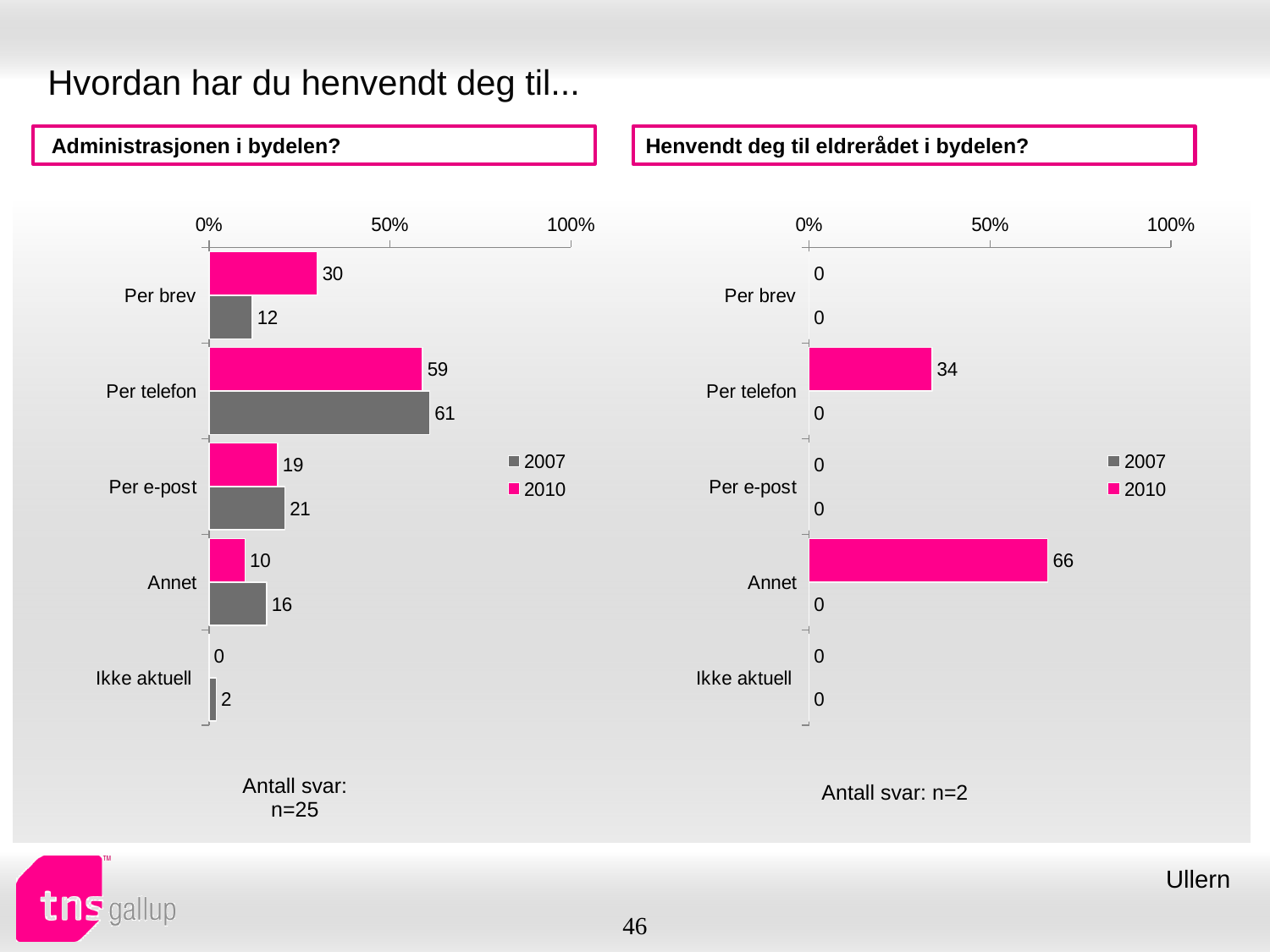
In the 'Administrasjonen i bydelen?' chart, is the 2007 value for Per telefon greater or less than 50%? greater In the 'Henvendt deg til eldrerådet i bydelen?' chart, what is the value for Annet in 2010? 66 In the 'Administrasjonen i bydelen?' chart, what is the difference between the 2010 and 2007 values for Per brev? 18 In the 'Administrasjonen i bydelen?' chart, what is the value for Per telefon in 2007? 61 How many categories are shown in the 'Henvendt deg til eldrerådet i bydelen?' chart? 5 In the 'Administrasjonen i bydelen?' chart, what is the value for Per brev in 2010? 30 In the 'Administrasjonen i bydelen?' chart, which category has the lowest value for 2007? Ikke aktuell In the 'Henvendt deg til eldrerådet i bydelen?' chart, what is the number of responses (Antall svar) shown below the chart? n=2 In the 'Administrasjonen i bydelen?' chart, which category has the highest value for 2010? Per telefon What kind of chart is the 'Henvendt deg til eldrerådet i bydelen?' chart? Bar chart In the 'Administrasjonen i bydelen?' chart, which is larger for Annet: the 2007 value or the 2010 value? 2007 How many series does the legend list in the 'Henvendt deg til eldrerådet i bydelen?' chart? 2